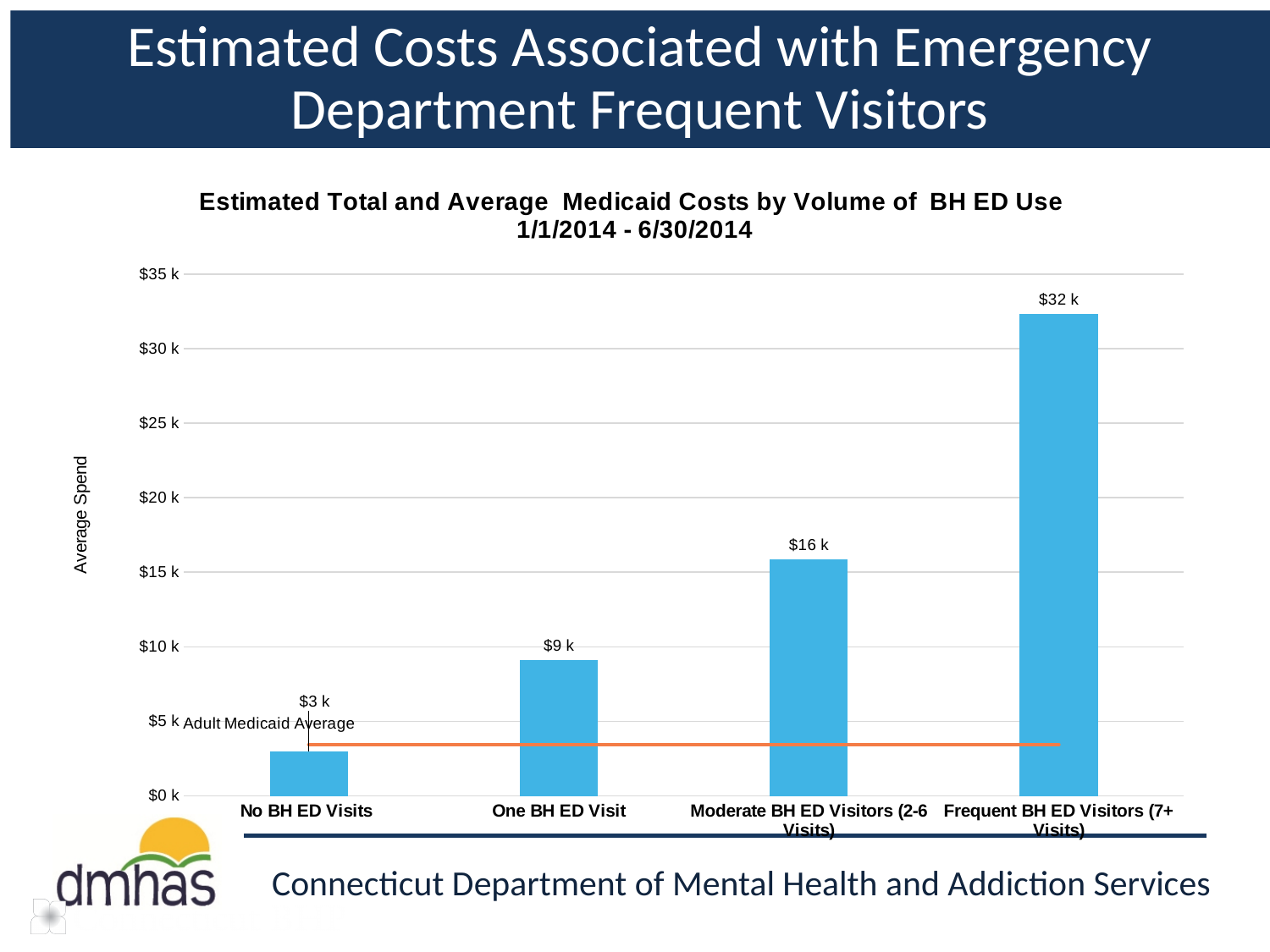
Which is larger, the value for One BH ED Visit or the value for Moderate BH ED Visitors (2-6 Visits)? Moderate BH ED Visitors (2-6 Visits) Which category has the highest average spend? Frequent BH ED Visitors (7+ Visits) What does the orange horizontal line on the chart represent? Adult Medicaid Average What is the value for One BH ED Visit? $9 k Which category has the lowest average spend? No BH ED Visits How many categories are shown on the x axis? 4 Is the value for Frequent BH ED Visitors (7+ Visits) greater or less than $30 k? greater What is the difference between the values for Frequent BH ED Visitors (7+ Visits) and Moderate BH ED Visitors (2-6 Visits)? $16 k What is the value for Moderate BH ED Visitors (2-6 Visits)? $16 k What is the value for No BH ED Visits? $3 k What is the value for Frequent BH ED Visitors (7+ Visits)? $32 k What kind of chart is shown on the slide? bar chart